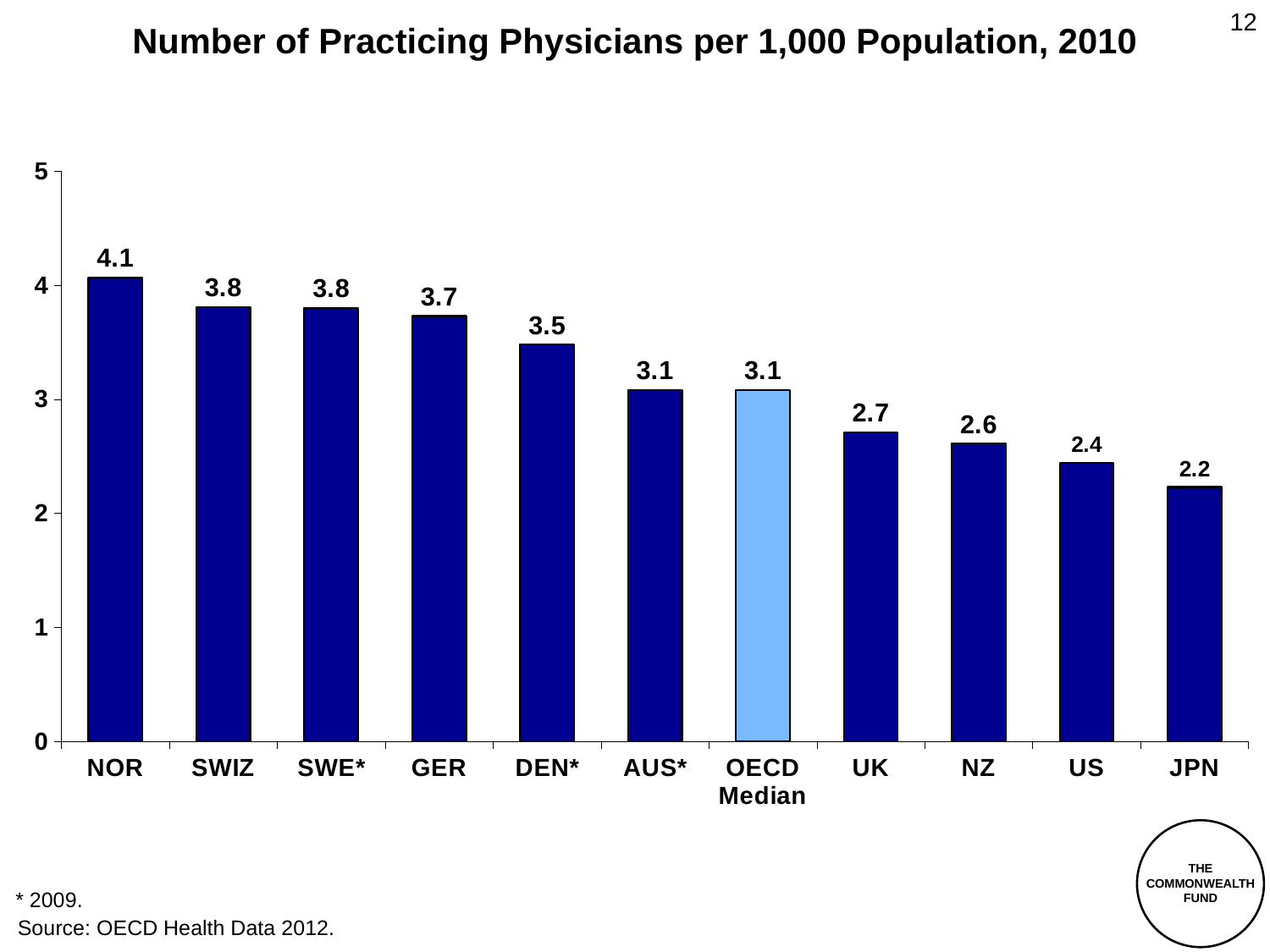
What is the value shown for the US? 2.4 Which country has the lowest number of practicing physicians per 1,000 population? JPN What is the value shown for the OECD Median? 3.1 What is the number of practicing physicians per 1,000 population for NOR? 4.1 Which country has the highest number of practicing physicians per 1,000 population? NOR How many bars are shown in the chart? 11 Which has a higher value, DEN* or NZ? DEN* Which bar is shown in a lighter blue colour than the others? OECD Median What kind of chart is shown on the slide? Bar chart Is the value for SWIZ greater or less than 3? greater What is the difference between the values for GER and the UK? 1.0 What is the difference between the values for NOR and JPN? 1.9